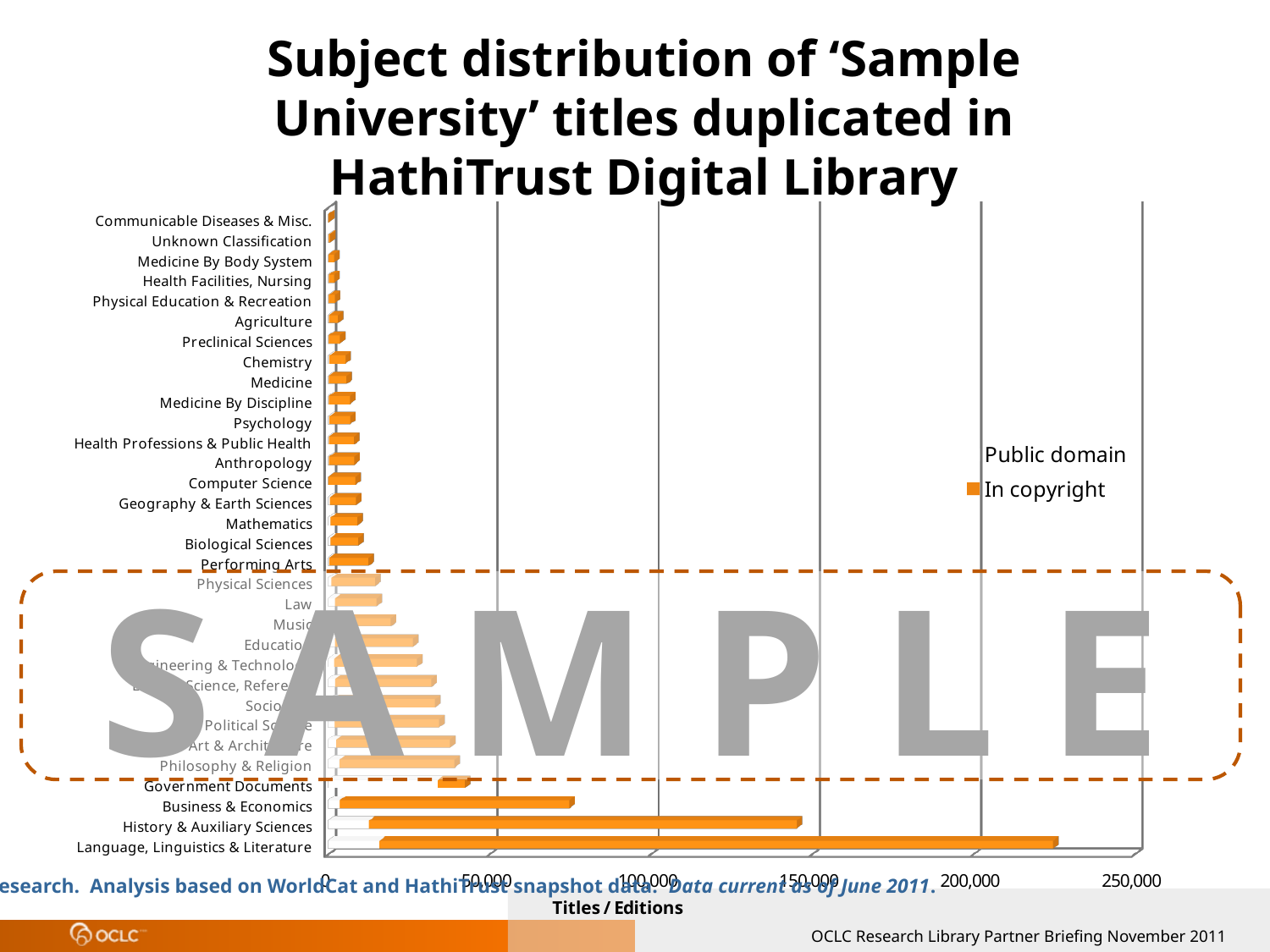
What are the two series named in the legend? Public domain and In copyright What kind of chart is shown on the slide? bar chart Is the total value for Philosophy & Religion greater or less than 50,000? less Which has the larger total, Business & Economics or History & Auxiliary Sciences? History & Auxiliary Sciences Is the total value for History & Auxiliary Sciences greater or less than 100,000? greater Is the total value for Business & Economics greater or less than 100,000? less Which subject has the longest bar? Language, Linguistics & Literature How many series does the legend list? 2 Which subject has the shortest bar? Communicable Diseases & Misc. What is the title of the horizontal axis? Titles / Editions